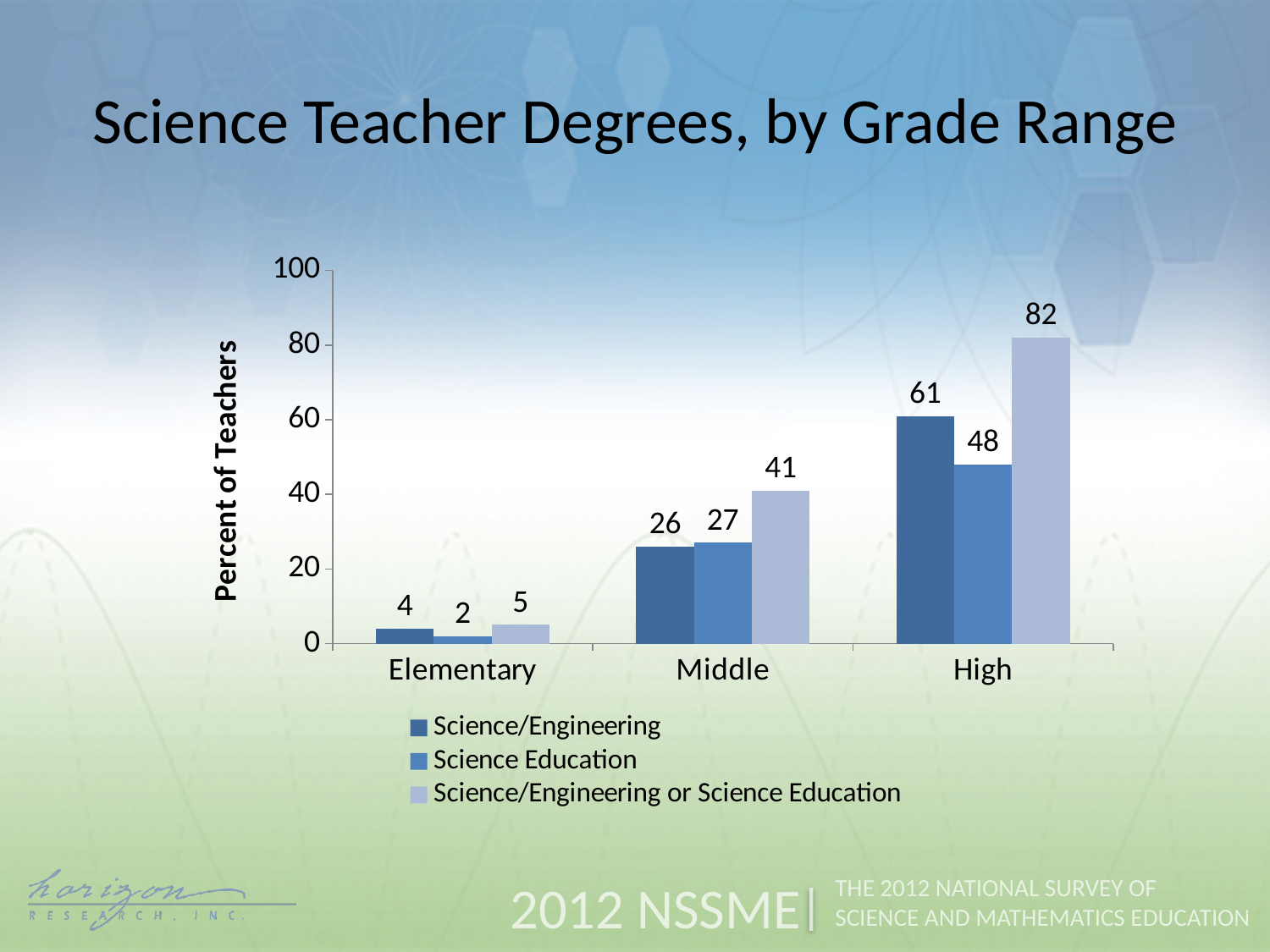
What is the value for Science/Engineering in the High grade range? 61 How many grade ranges are shown on the x axis? 3 What is the label of the y axis? Percent of Teachers What is the difference between the Science/Engineering or Science Education values for High and Middle? 41 Is the value for Science/Engineering or Science Education in the High grade range greater or less than 80? greater What kind of chart is shown on the slide? bar chart Which grade range has the highest value for Science/Engineering or Science Education? High What is the value for Science Education in the Middle grade range? 27 What is the value for Science/Engineering or Science Education in the Elementary grade range? 5 Which is larger in the High grade range: Science/Engineering or Science Education? Science/Engineering Which grade range has the lowest value for Science Education? Elementary How many series does the legend list? 3